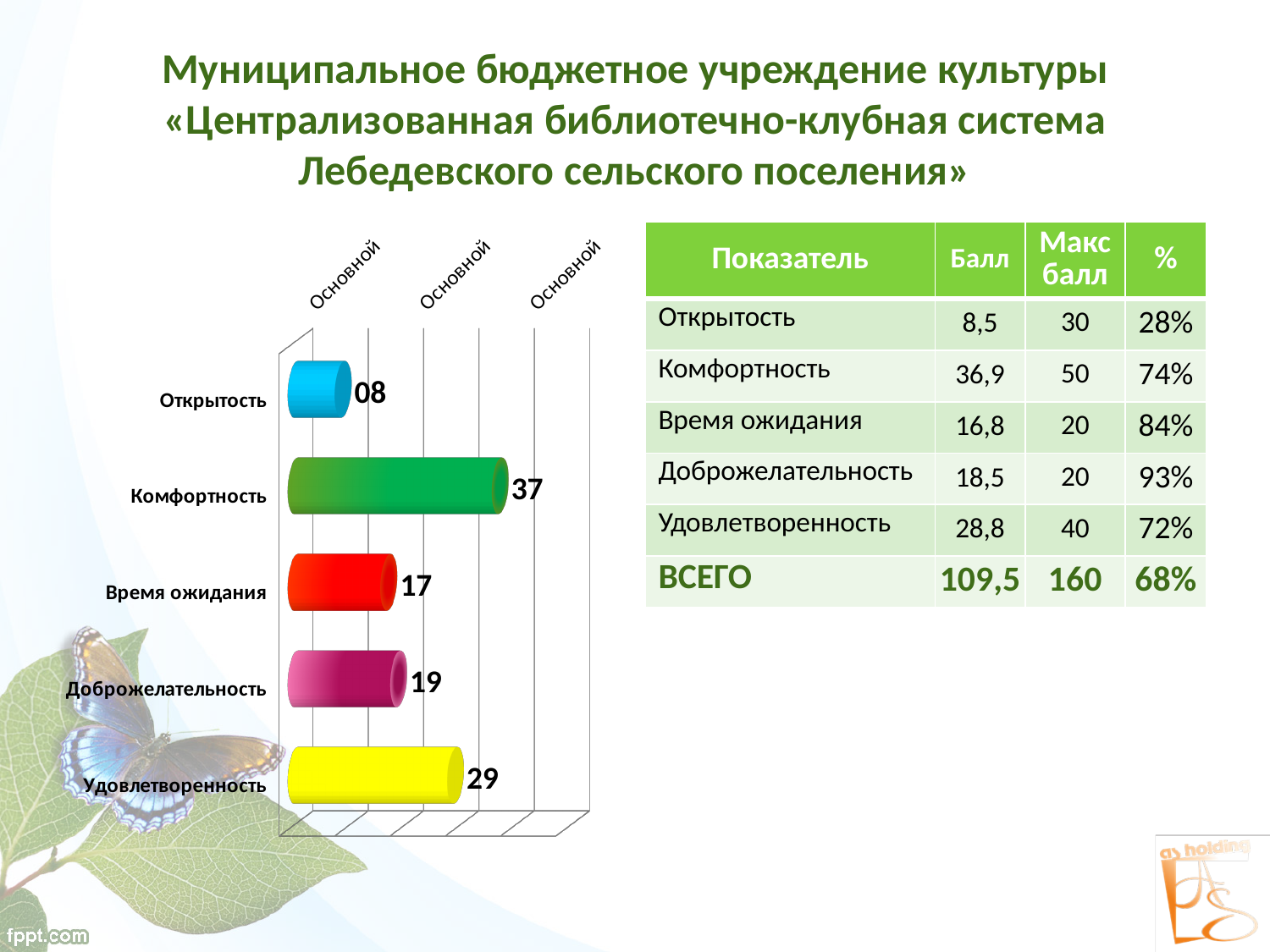
Which category has the lowest value in the bar chart? Открытость What is the difference between the values for Комфортность and Удовлетворенность in the bar chart? 8 What colour is the bar for Удовлетворенность in the bar chart? yellow What is the value shown for Удовлетворенность in the bar chart? 29 What is the value shown for Открытость in the bar chart? 08 What is the value shown for Доброжелательность in the bar chart? 19 How many categories does the bar chart show? 5 Which is larger in the bar chart, the value for Доброжелательность or the value for Время ожидания? Доброжелательность Which category has the highest value in the bar chart? Комфортность What kind of chart is shown on the left of the slide? bar chart What is the value shown for Время ожидания in the bar chart? 17 What is the value shown for Комфортность in the bar chart? 37